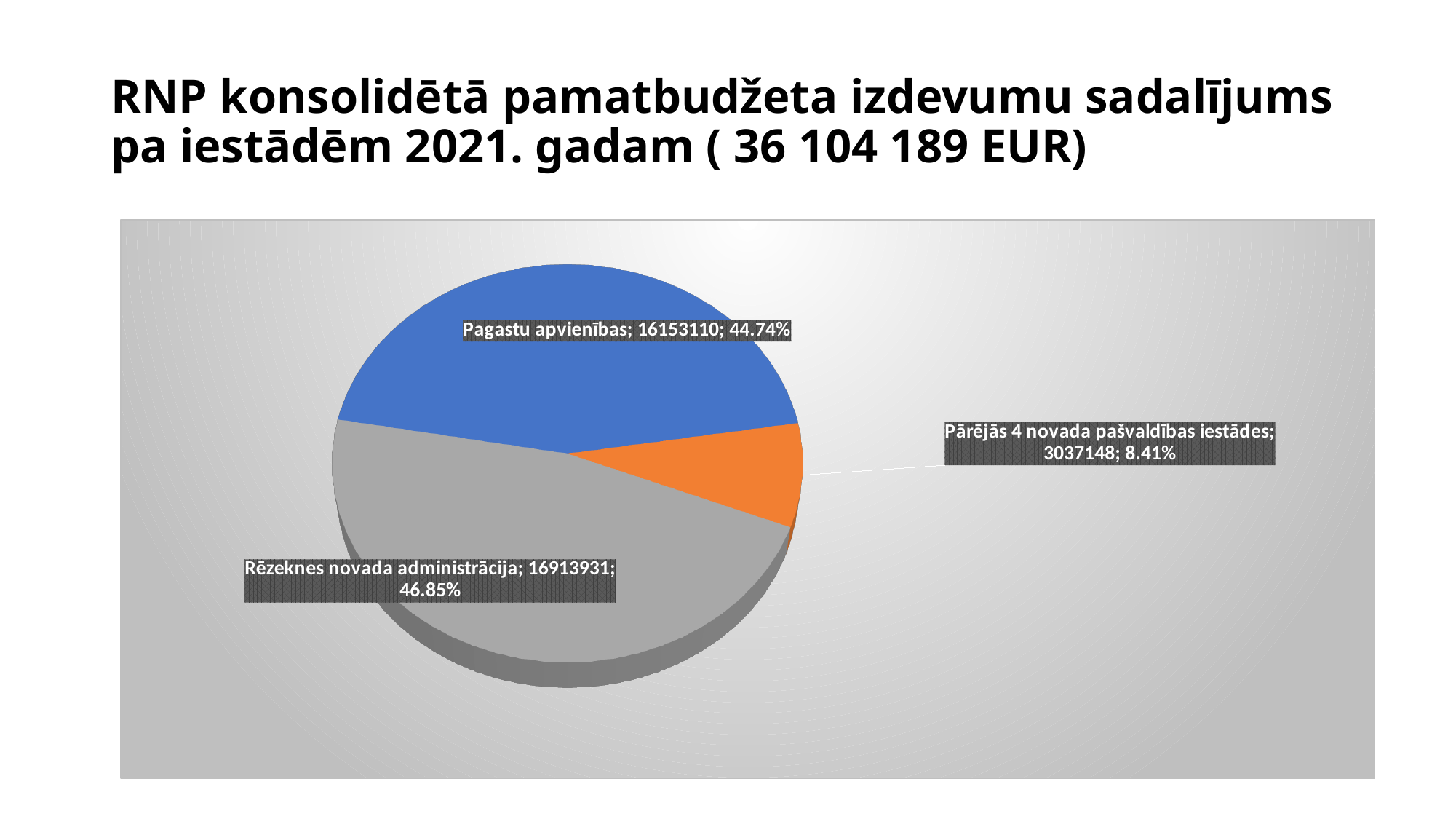
What is the value for Pagastu apvienības? 16153110 What share of the pie does Pagastu apvienības represent? 44.74% What kind of chart is shown on the slide? pie chart What is the value for Rēzeknes novada administrācija? 16913931 What share of the pie does Pārējās 4 novada pašvaldības iestādes represent? 8.41% Which category has the smallest slice of the pie? Pārējās 4 novada pašvaldības iestādes What is the difference between the values for Rēzeknes novada administrācija and Pagastu apvienības? 760821 What colour is the slice for Pārējās 4 novada pašvaldības iestādes? orange How many slices does the pie chart have? 3 What is the value for Pārējās 4 novada pašvaldības iestādes? 3037148 Which category has the largest slice of the pie? Rēzeknes novada administrācija Which is larger, the value for Pagastu apvienības or the value for Pārējās 4 novada pašvaldības iestādes? Pagastu apvienības